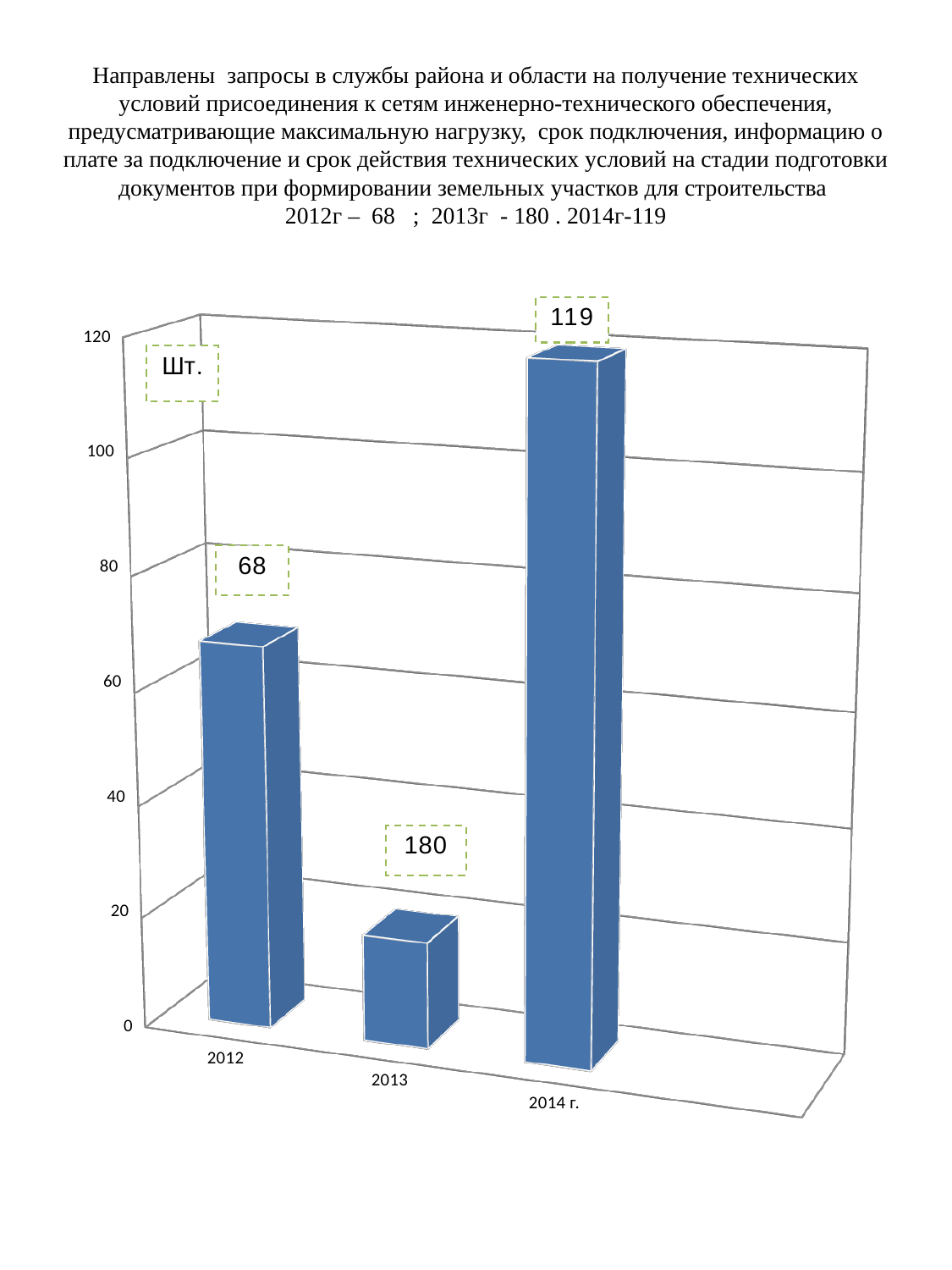
What value is printed above the bar for 2013? 180 Which is larger, the value for 2012 or the value for 2014 г.? 2014 г. What is the value shown for 2014 г.? 119 Is the value for 2012 greater or less than 60? greater What colour are the bars in the chart? blue What is the value shown for 2012? 68 What kind of chart is shown on the slide? bar chart How many categories (years) are shown on the chart? 3 Is the value for 2014 г. greater or less than 100? greater What is the difference between the values for 2014 г. and 2012? 51 What unit label is shown in the top-left corner of the chart? Шт.